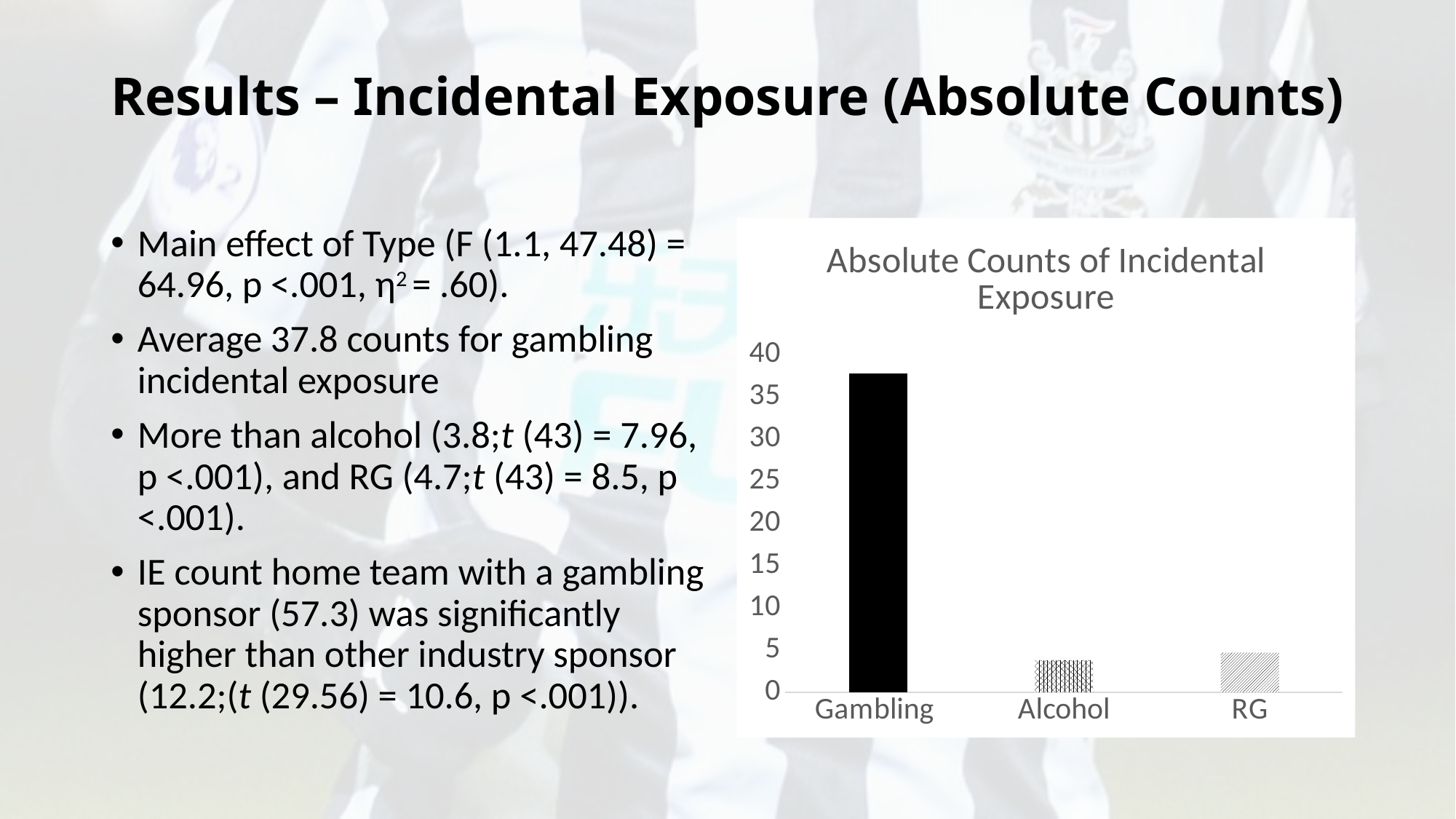
What is the maximum value shown on the y axis of the chart? 40 Is the value for Alcohol greater or less than 5? less Is the value for RG greater or less than 10? less Is the value for Gambling greater or less than 40? less Which category has the highest value in the chart? Gambling What type of chart is shown on the slide? bar chart What is the title of the chart? Absolute Counts of Incidental Exposure Which is larger, the value for Gambling or the value for Alcohol? Gambling How many categories are shown on the x axis of the chart? 3 Which is larger, the value for RG or the value for Gambling? Gambling